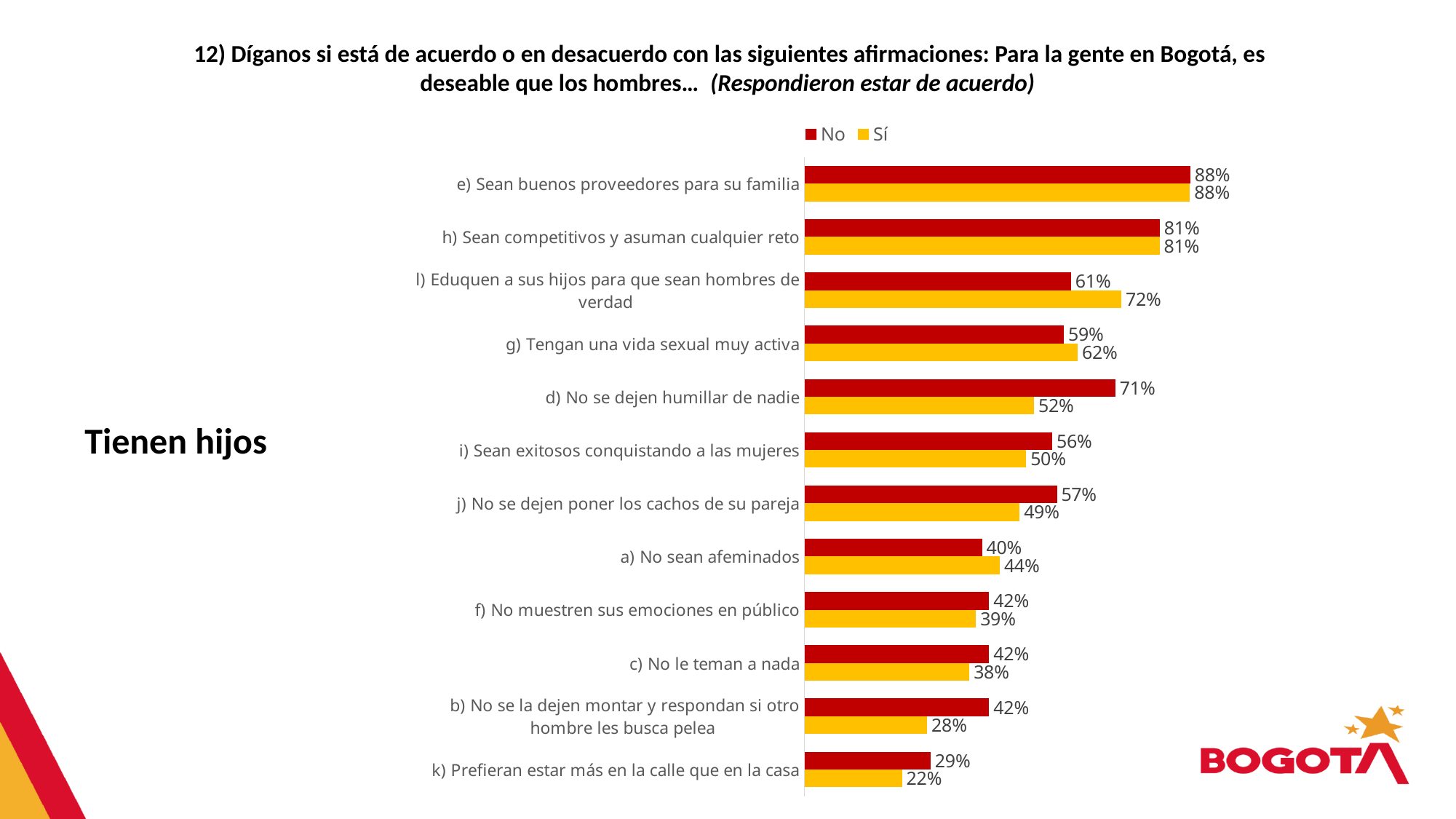
For "j) No se dejen poner los cachos de su pareja", which series has the larger value, "No" or "Sí"? No Which colour represents the "Sí" series in the chart? Yellow Which category has the highest value in the "No" series? e) Sean buenos proveedores para su familia How many categories (statements) are shown in the chart? 12 For "a) No sean afeminados", which series has the larger value, "No" or "Sí"? Sí What is the difference between the "No" and "Sí" values for "d) No se dejen humillar de nadie"? 19 percentage points What kind of chart is shown on the slide? Bar chart Which category has the lowest value in the "Sí" series? k) Prefieran estar más en la calle que en la casa What is the value of the "No" series for "d) No se dejen humillar de nadie"? 71% How many series does the legend list? 2 What is the value of the "Sí" series for "l) Eduquen a sus hijos para que sean hombres de verdad"? 72% What is the value of the "Sí" series for "b) No se la dejen montar y respondan si otro hombre les busca pelea"? 28%